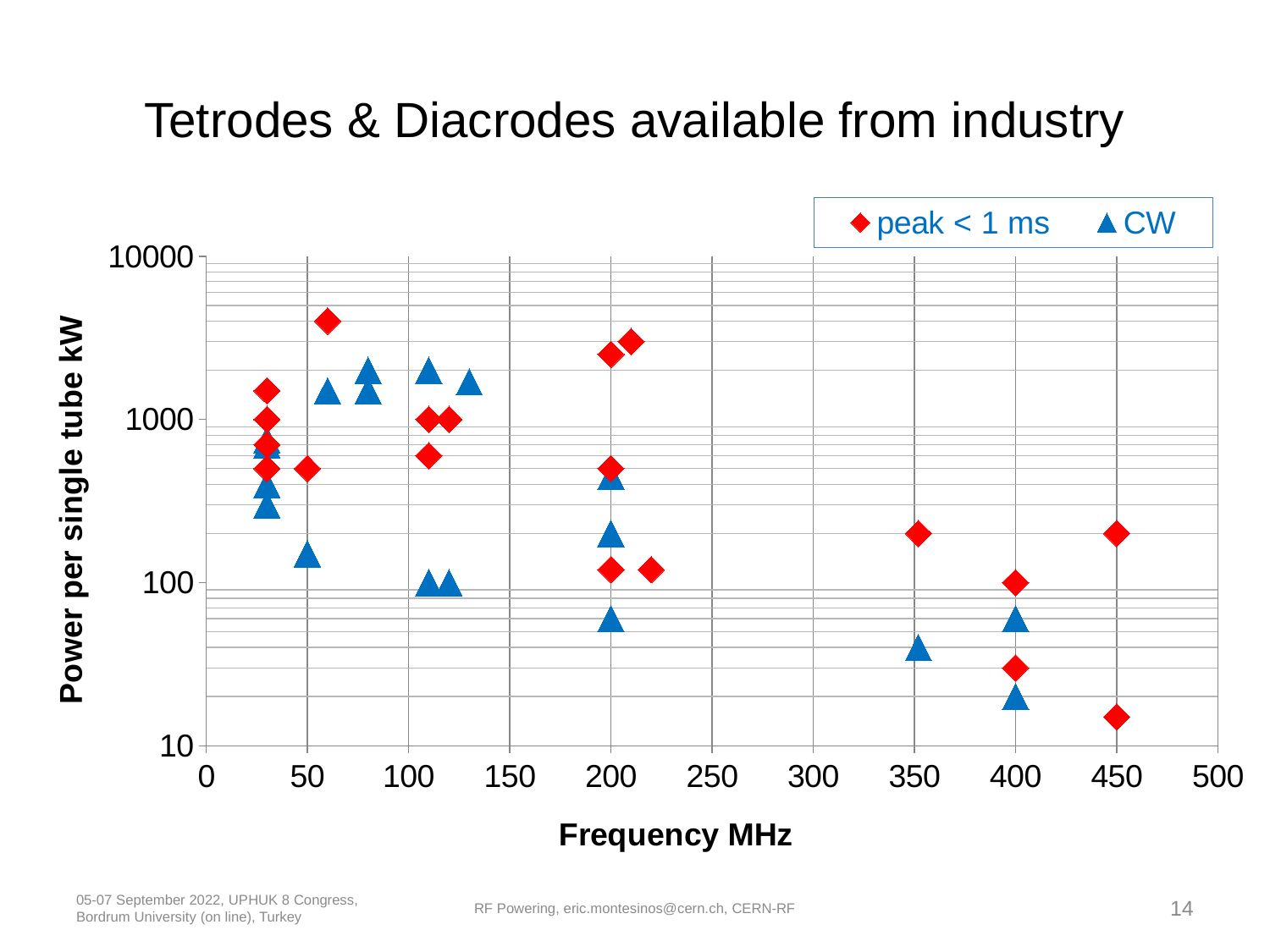
Which series contains the highest plotted point on the chart? peak < 1 ms What are the two series named in the legend? peak < 1 ms and CW Which series contains the lowest plotted point on the chart? peak < 1 ms At 350 MHz, which series has the higher power value, peak < 1 ms or CW? peak < 1 ms What kind of chart is shown on the slide? scatter chart What is the title of the vertical axis? Power per single tube kW Is the peak < 1 ms point at 350 MHz greater or less than 100 kW? greater Is the CW point at 350 MHz greater or less than 100 kW? less How many series does the legend list? 2 Is the highest peak < 1 ms point (near 60 MHz) greater or less than 1000 kW? greater Overall, do the plotted power values rise or fall as frequency increases along the x axis? fall